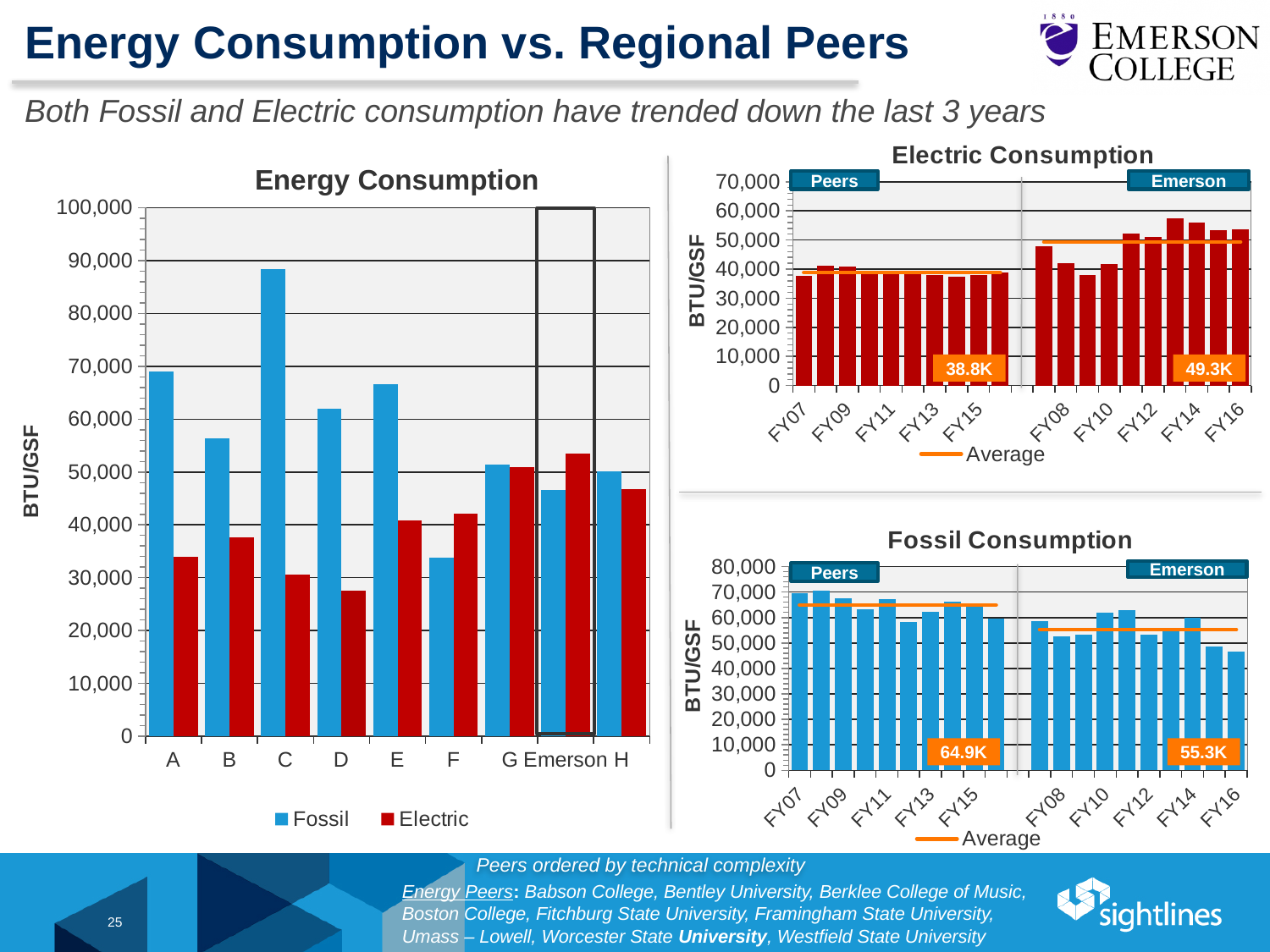
In the Electric Consumption chart, what is the labelled average for Emerson? 49.3K How many series does the legend of the Energy Consumption chart list? 2 In the Energy Consumption chart, which category has the highest Fossil value? C What kind of chart is the Energy Consumption chart on the left? Bar chart What is the y-axis label on the Fossil Consumption chart? BTU/GSF In the Energy Consumption chart, for Emerson, which is larger: Fossil or Electric? Electric In the Electric Consumption chart, what is the labelled average for Peers? 38.8K In the Energy Consumption chart, which category has the lowest Electric value? D In the Fossil Consumption chart, what is the difference between the Peers average and the Emerson average? 9.6K How many categories are shown on the x axis of the Energy Consumption chart? 9 In the Energy Consumption chart, which category has the lowest Fossil value? F In the Energy Consumption chart, is the Fossil value for C greater or less than 80,000? greater